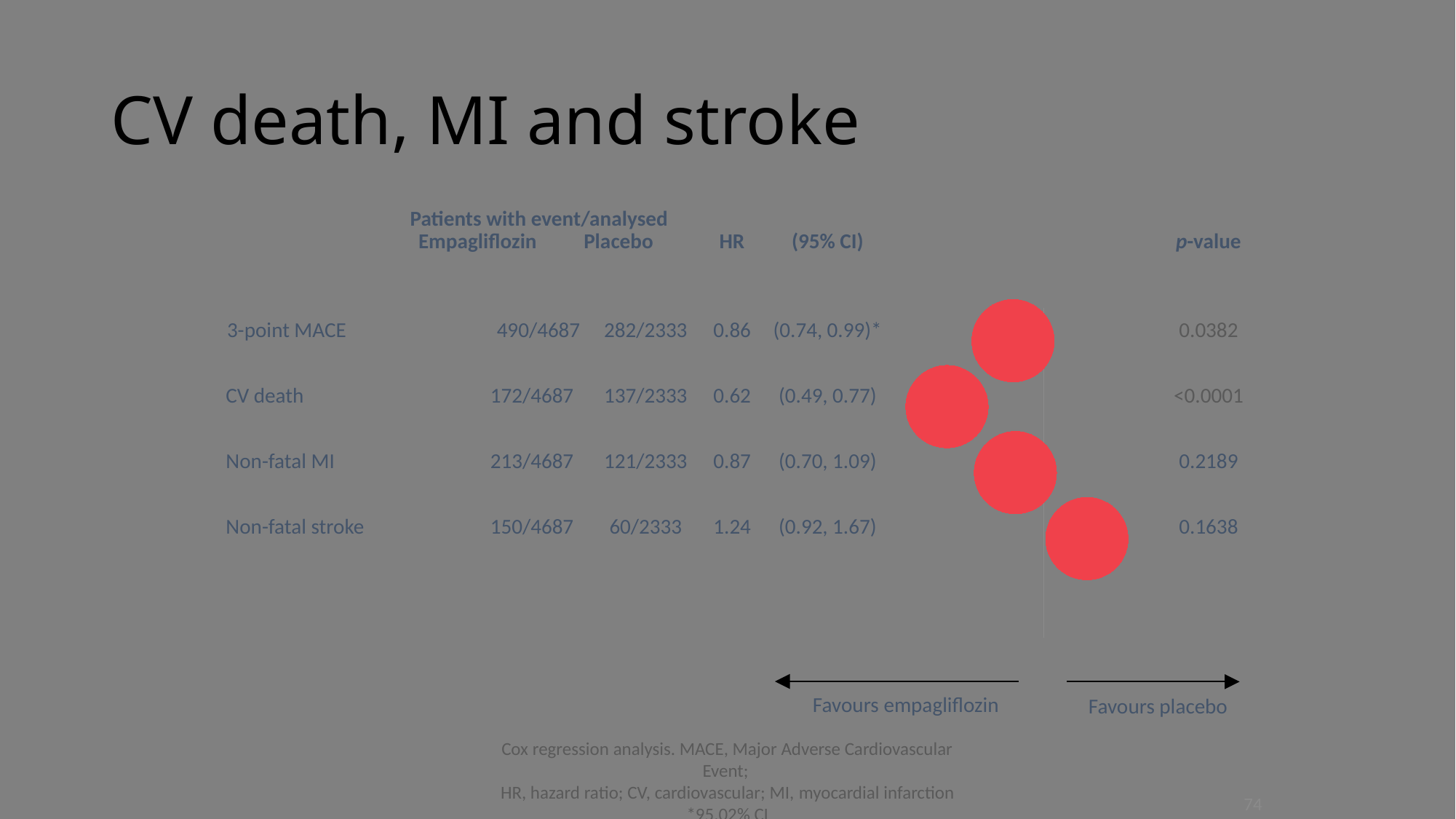
Which has a larger hazard ratio, CV death or Non-fatal stroke? Non-fatal stroke What kind of chart is shown on the slide? Forest plot What is the hazard ratio (HR) for CV death? 0.62 How many outcomes are plotted in the forest plot? 4 Which outcome has the lowest hazard ratio? CV death What is the p-value for 3-point MACE? 0.0382 Is the hazard ratio for Non-fatal stroke greater or less than 1? greater What is the difference between the hazard ratios for Non-fatal stroke and CV death? 0.62 Which outcome has the highest hazard ratio? Non-fatal stroke What is the 95% CI for Non-fatal MI? (0.70, 1.09) What does the label under the left-pointing arrow say? Favours empagliflozin What is the number of patients with event/analysed in the Placebo group for Non-fatal stroke? 60/2333